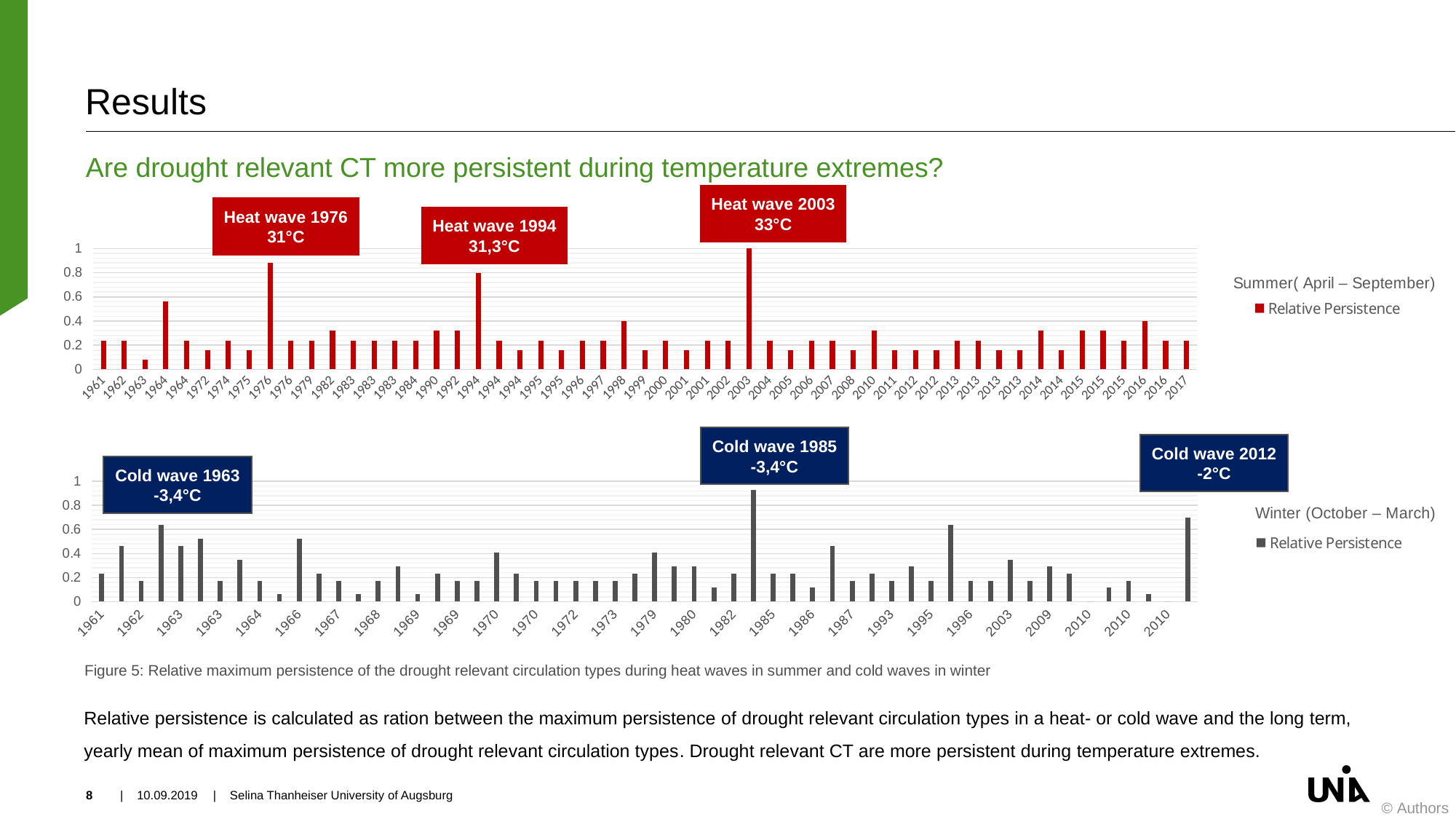
In the Winter (October – March) chart, is the value for 1985 greater or less than 0.8? greater How many series does the legend of the Winter (October – March) chart list? 1 What is the legend entry shown for the Summer (April – September) chart? Relative Persistence In the Winter (October – March) chart, which year has the highest relative persistence? 1985 In the Summer (April – September) chart, which is larger, the value for 2003 or the value for 1976? 2003 What kind of chart is the Summer (April – September) chart? bar chart In the Summer (April – September) chart, which year has the highest relative persistence? 2003 In the Summer (April – September) chart, is the value for 1976 greater or less than 0.8? greater In the Winter (October – March) chart, which is larger, the value for 1985 or the value for 1996? 1985 What temperature is given in the annotation box for Heat wave 2003 on the Summer chart? 33°C